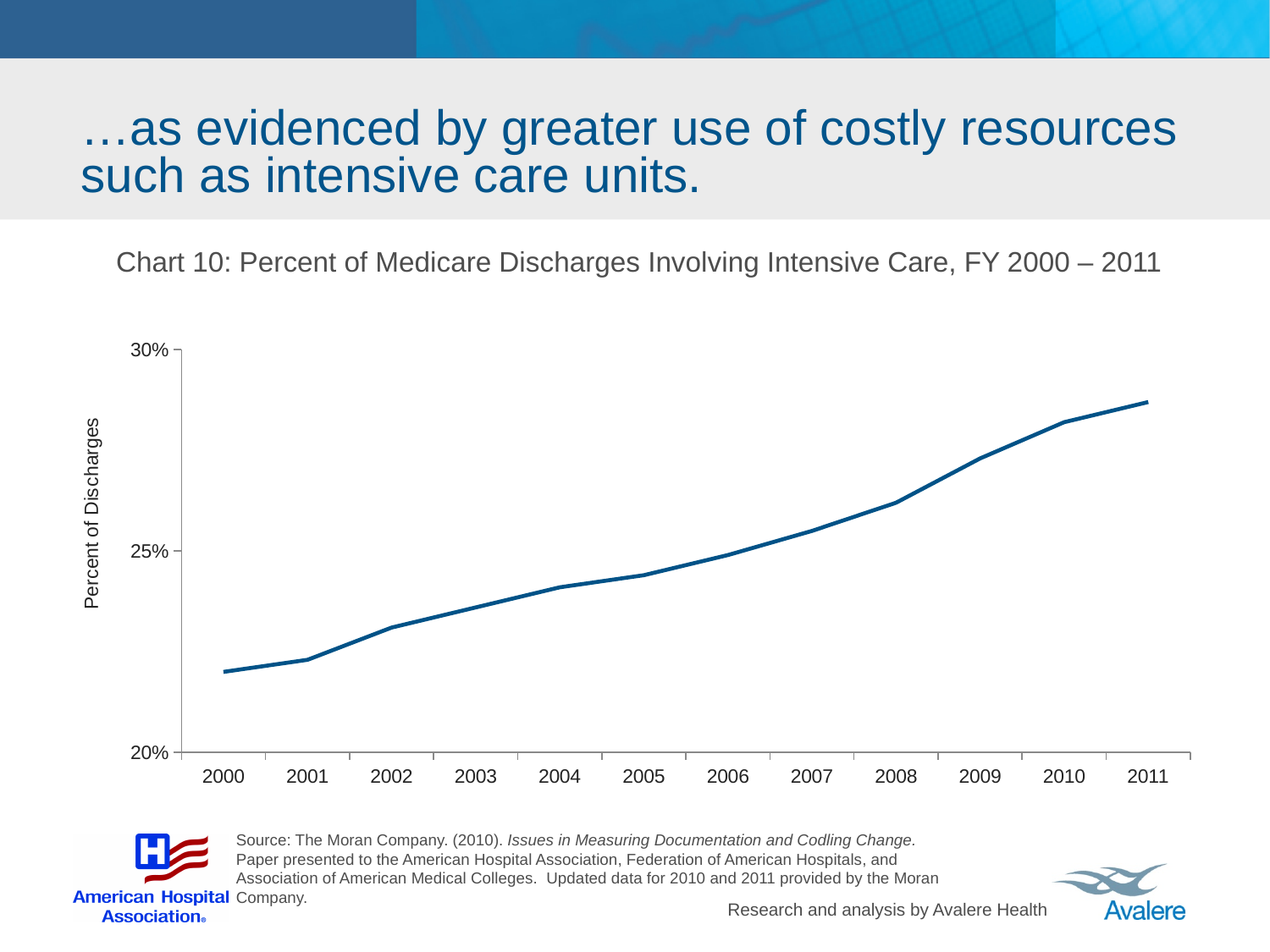
What kind of chart is shown on the slide? Line chart Is the value for 2000 greater or less than 25%? less How many years are plotted along the x axis? 12 Is the value for 2009 greater or less than 25%? greater What is the title of the chart? Chart 10: Percent of Medicare Discharges Involving Intensive Care, FY 2000 – 2011 Which year has the lowest percent of Medicare discharges involving intensive care? 2000 Is the value for 2011 greater or less than 25%? greater Which year has the highest percent of Medicare discharges involving intensive care? 2011 What is the label on the y axis? Percent of Discharges Which year has the larger value, 2002 or 2010? 2010 Do the values rise or fall from 2000 to 2011? Rise